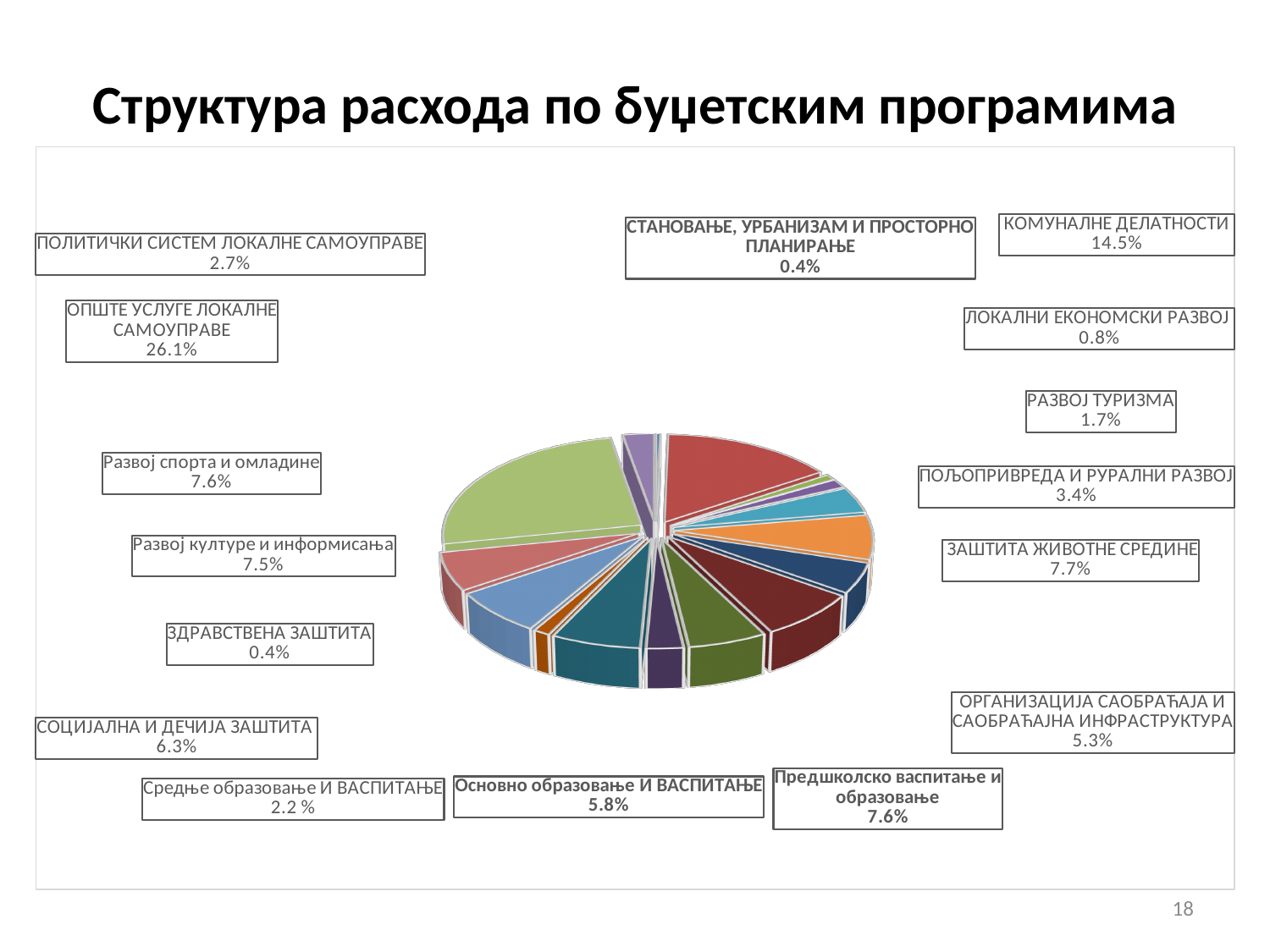
What is the difference in percentage points between ОПШТЕ УСЛУГЕ ЛОКАЛНЕ САМОУПРАВЕ and КОМУНАЛНЕ ДЕЛАТНОСТИ? 11.6 percentage points What share of expenditure goes to КОМУНАЛНЕ ДЕЛАТНОСТИ? 14.5% Which has a larger share, СОЦИЈАЛНА И ДЕЧИЈА ЗАШТИТА or ПОЉОПРИВРЕДА И РУРАЛНИ РАЗВОЈ? СОЦИЈАЛНА И ДЕЧИЈА ЗАШТИТА How many budget programmes (slices) are shown in the pie chart? 16 What kind of chart is shown on the slide? pie chart What share of expenditure goes to ОПШТЕ УСЛУГЕ ЛОКАЛНЕ САМОУПРАВЕ? 26.1% What is the title of the slide? Структура расхода по буџетским програмима What is the value shown for ОРГАНИЗАЦИЈА САОБРАЋАЈА И САОБРАЋАЈНА ИНФРАСТРУКТУРА? 5.3% What is the value shown for РАЗВОЈ ТУРИЗМА? 1.7% Which budget programme has the largest share of expenditure? ОПШТЕ УСЛУГЕ ЛОКАЛНЕ САМОУПРАВЕ Which has a larger share, ЗАШТИТА ЖИВОТНЕ СРЕДИНЕ or Развој културе и информисања? ЗАШТИТА ЖИВОТНЕ СРЕДИНЕ What is the value shown for Предшколско васпитање и образовање? 7.6%